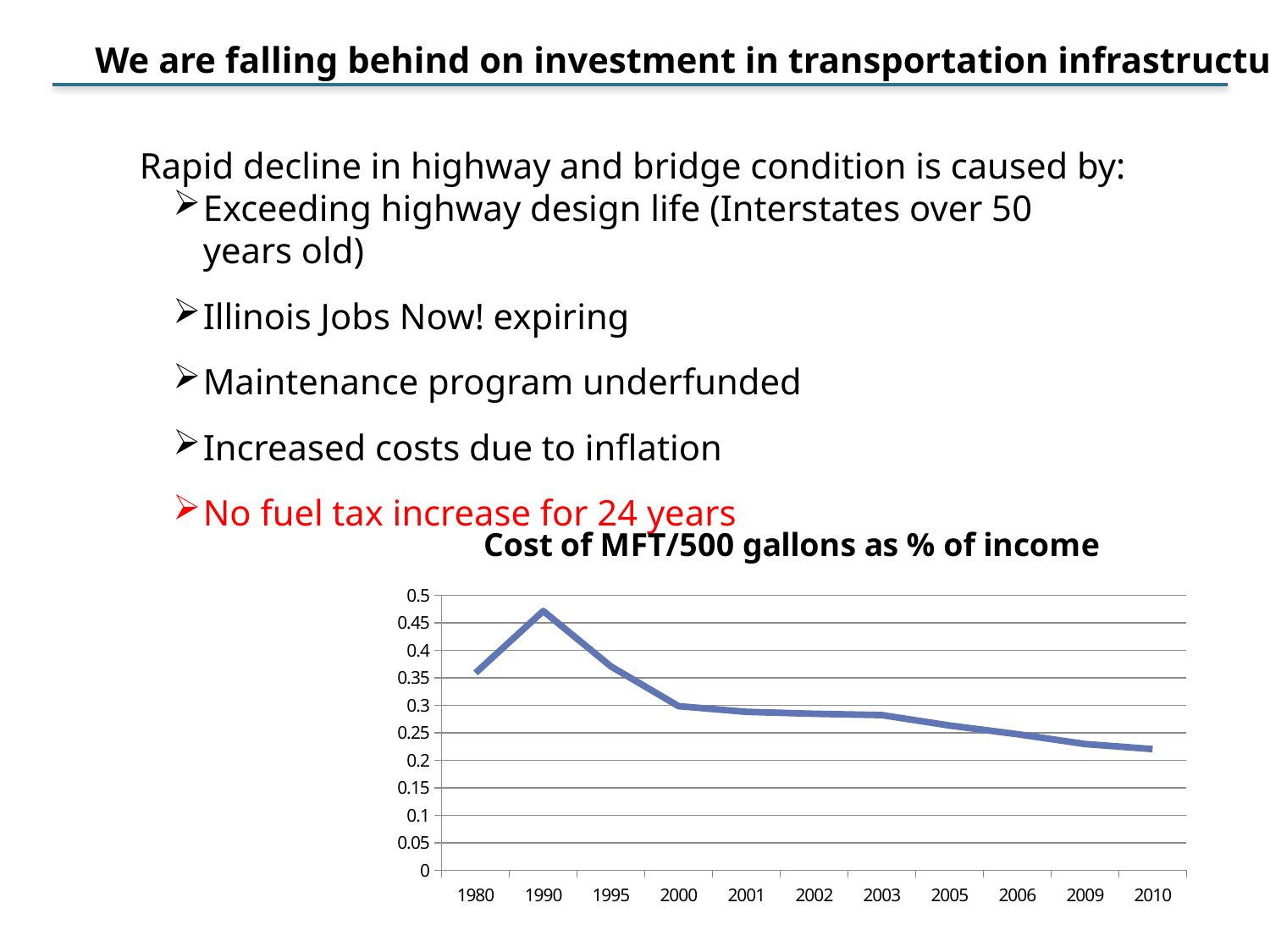
In which year is the cost of MFT/500 gallons as % of income highest? 1990 Which year has the larger value, 1990 or 1995? 1990 Is the value for 1980 greater or less than 0.4? less Does the value rise or fall from 1990 to 2010? fall Which year has the larger value, 1980 or 2000? 1980 How many years are plotted on the x axis of the chart? 11 Is the value for 2000 greater or less than 0.35? less Is the value for 1990 greater or less than 0.4? greater What is the title of the chart? Cost of MFT/500 gallons as % of income In which year is the cost of MFT/500 gallons as % of income lowest? 2010 What kind of chart is shown on the slide? line chart